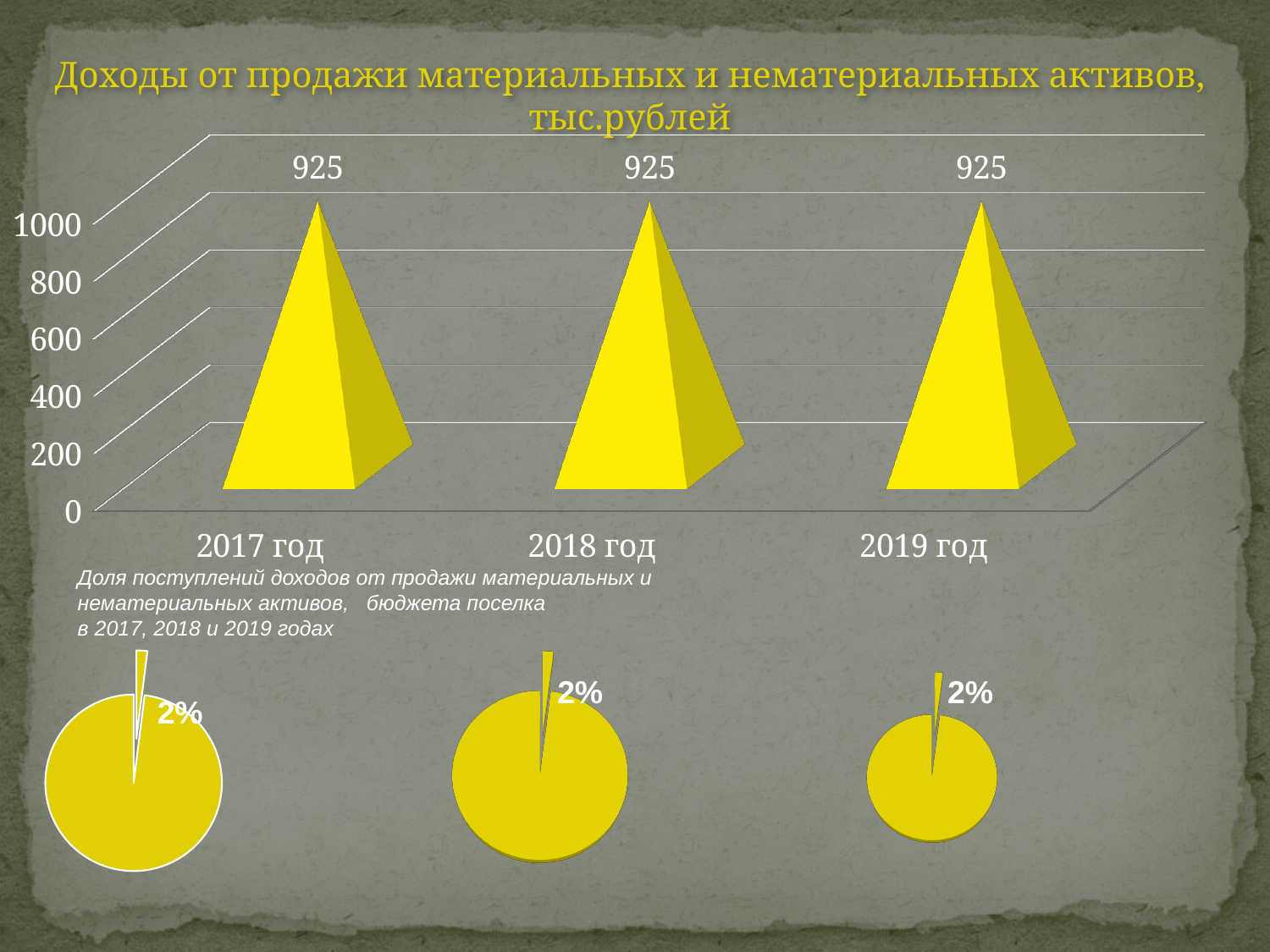
In the bar chart at the top, do the values rise, fall or stay the same from 2017 год to 2019 год? stay the same How many pie charts are shown at the bottom of the slide? 3 What is the title of the bar chart at the top of the slide? Доходы от продажи материальных и нематериальных активов, тыс.рублей In the bar chart at the top, what is the value for 2019 год? 925 In the leftmost pie chart at the bottom of the slide, what share is shown for the labelled slice? 2% In the bar chart at the top, what is the value for 2018 год? 925 How many categories are shown in the bar chart at the top of the slide? 3 In the bar chart at the top, is the value for 2018 год greater or less than 800? greater In the bar chart at the top, what is the difference between the values for 2017 год and 2019 год? 0 What kind of chart is the chart at the top of the slide? bar chart In the bar chart at the top, what is the value for 2017 год? 925 In the bar chart at the top, is the value for 2017 год larger than, smaller than, or equal to the value for 2018 год? equal